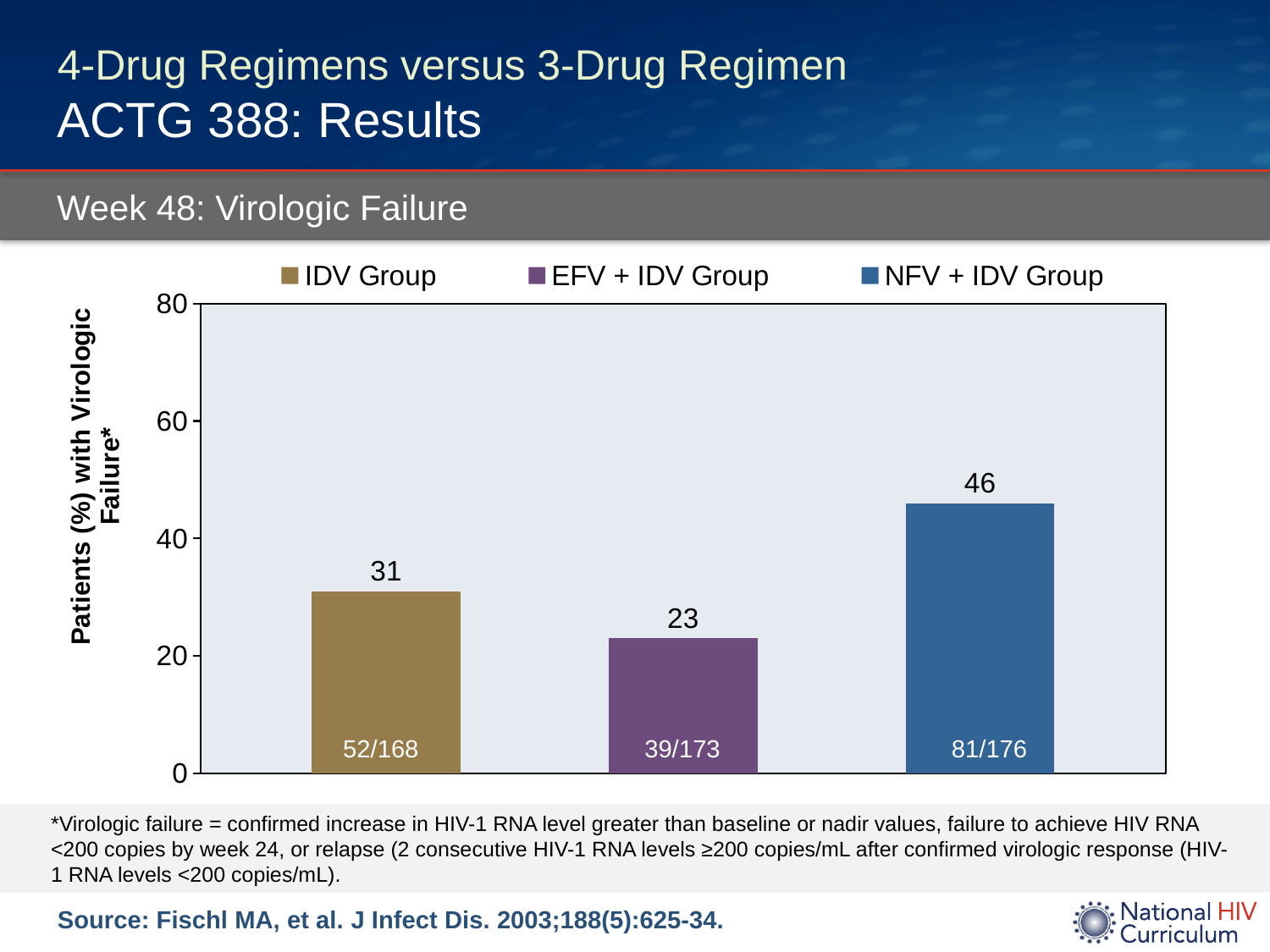
How many groups are shown in the chart? 3 What fraction is printed inside the bar for the EFV + IDV Group? 39/173 Which group had the highest percentage of patients with virologic failure? NFV + IDV Group What type of chart is shown on the slide? Bar chart Which group had the lowest percentage of patients with virologic failure? EFV + IDV Group How many series does the legend list? 3 What percentage of patients in the NFV + IDV Group had virologic failure at week 48? 46 What percentage of patients in the EFV + IDV Group had virologic failure at week 48? 23 What is the difference in virologic failure percentage between the NFV + IDV Group and the EFV + IDV Group? 23 Which group had a higher percentage of virologic failure, the IDV Group or the EFV + IDV Group? IDV Group What percentage of patients in the IDV Group had virologic failure at week 48? 31 What fraction is printed inside the bar for the NFV + IDV Group? 81/176